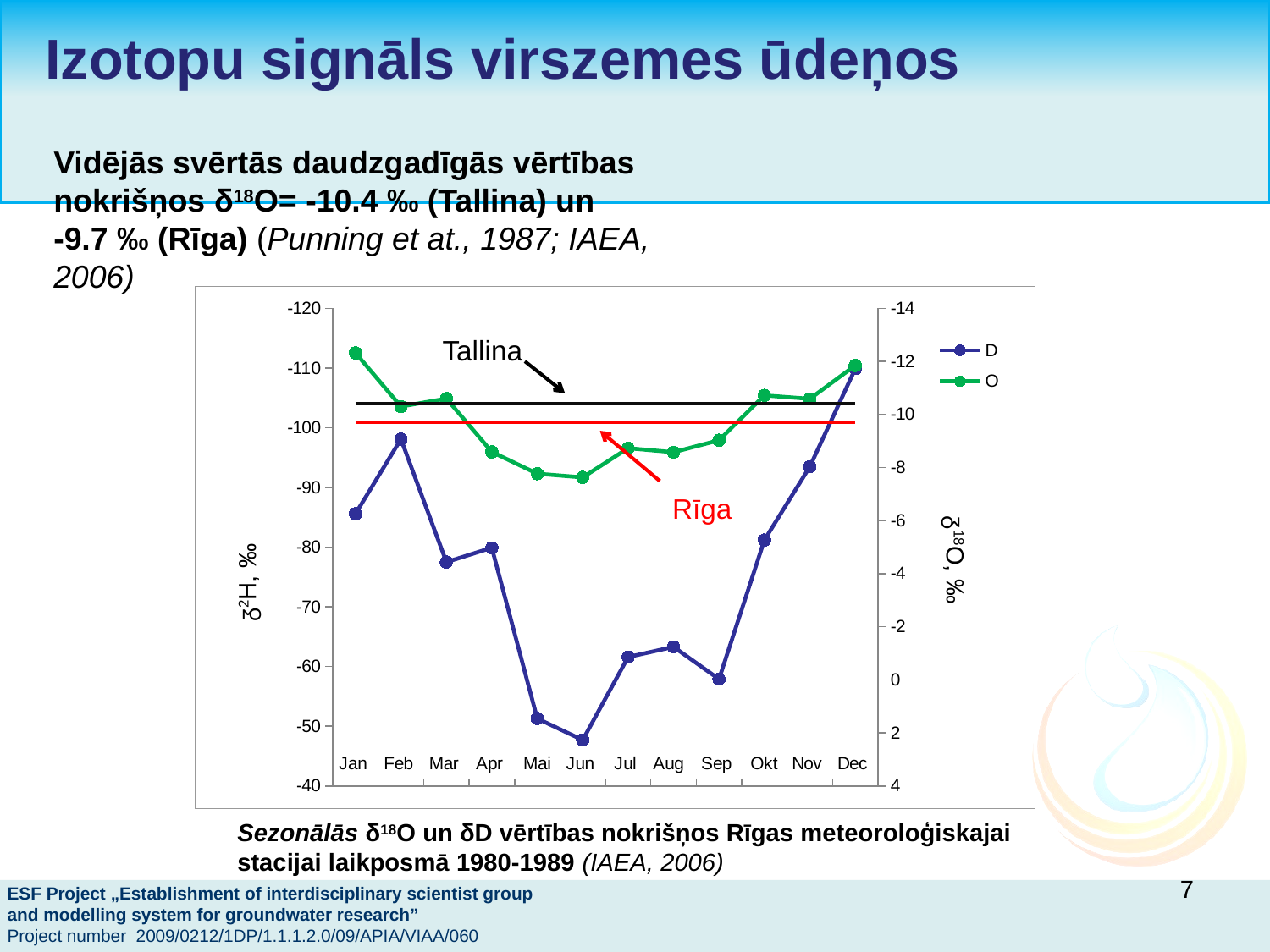
Do the values of the D series rise or fall from Sep to Dec? fall For the D series, which month has the larger value, Okt or Nov? Okt How many months are plotted along the x axis of the chart? 12 Is the value for the O series in Jun greater or less than -10? greater Is the value for the D series in Jan greater or less than -80? less What kind of chart is shown on the slide? line chart Which month has the highest (least negative) value for the D series? Jun How many series does the chart legend list? 2 Which month has the lowest (most negative) value for the D series? Dec Is the value for the D series in Dec greater or less than -100? less